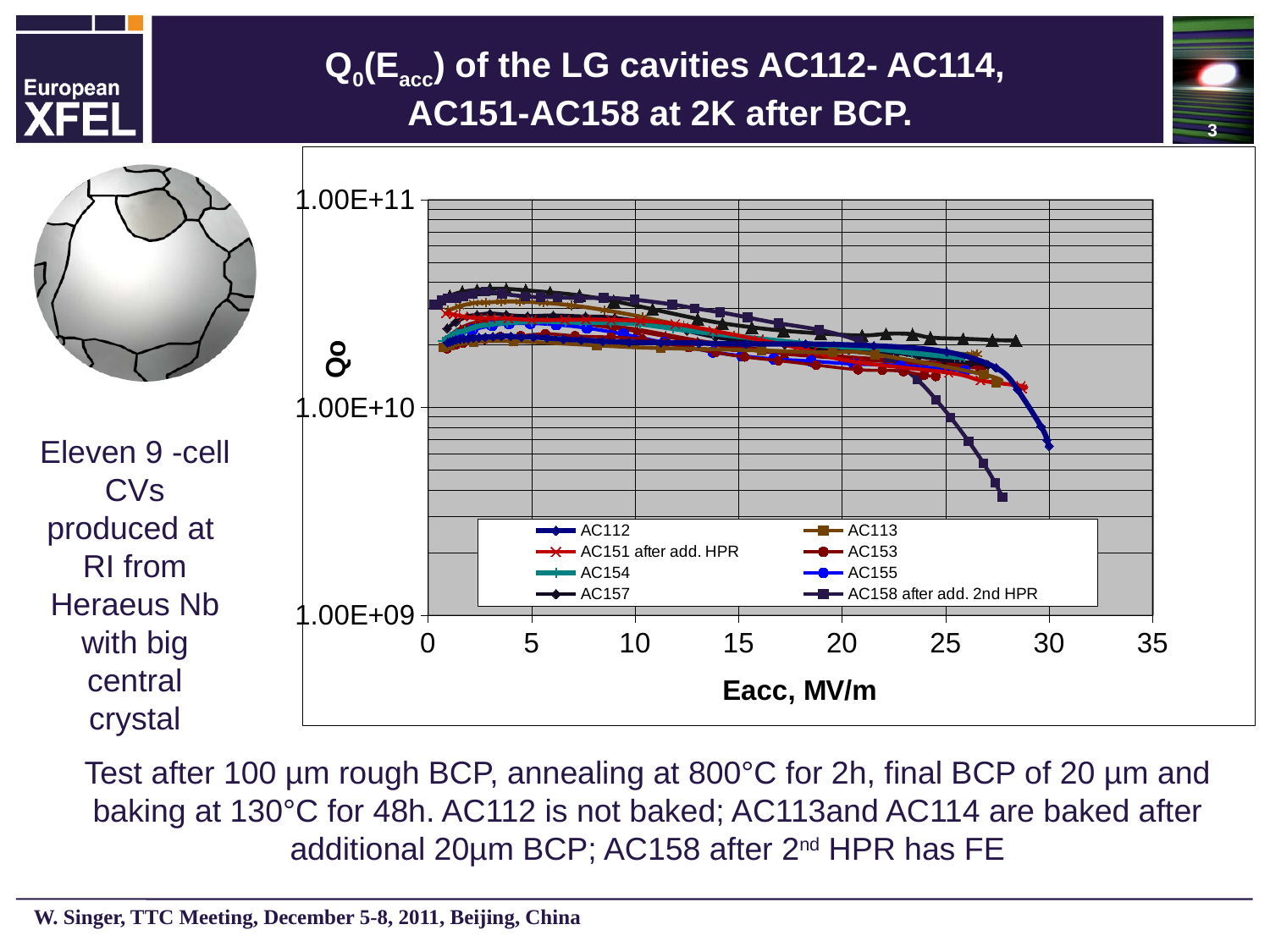
Is the Q0 value of AC157 at 25 MV/m greater or less than 1.00E+10? greater What is the label of the x axis of the chart? Eacc, MV/m Is the Q0 value of AC157 at 5 MV/m greater or less than 1.00E+11? less Which series ends at the lowest Q0 value on the chart? AC158 after add. 2nd HPR How many series does the chart legend list? 8 As Eacc increases along the x axis, do the Q0 values of the cavities generally rise or fall? Fall What is the label of the y axis of the chart? Qo At 25 MV/m, which series has the higher Q0: AC157 or AC158 after add. 2nd HPR? AC157 What kind of chart is shown on the slide? Line chart Is the Q0 value of the last point of AC112 (near 30 MV/m) greater or less than 1.00E+10? less Which series reaches the highest Eacc value on the chart? AC112